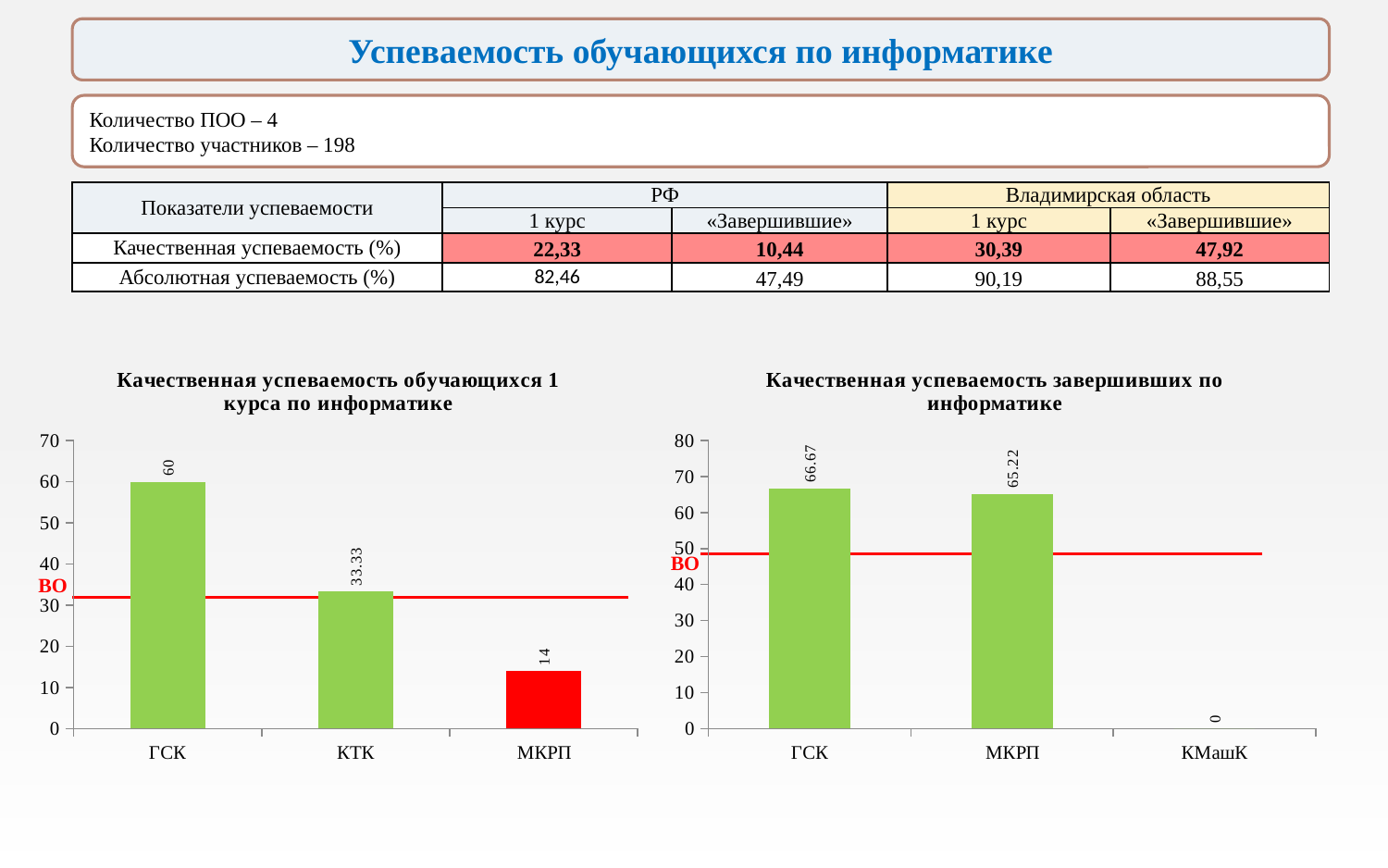
In the chart 'Качественная успеваемость обучающихся 1 курса по информатике', what is the value for ГСК? 60 In the chart 'Качественная успеваемость завершивших по информатике', is the value for МКРП greater or less than 60? greater In the chart 'Качественная успеваемость обучающихся 1 курса по информатике', which category has the lowest value? МКРП In the chart 'Качественная успеваемость завершивших по информатике', what is the value for ГСК? 66.67 What kind of chart is 'Качественная успеваемость завершивших по информатике'? bar chart In the chart 'Качественная успеваемость обучающихся 1 курса по информатике', what is the value for МКРП? 14 In the chart 'Качественная успеваемость обучающихся 1 курса по информатике', how many categories are shown on the x axis? 3 In the chart 'Качественная успеваемость завершивших по информатике', what is the value for МКРП? 65.22 In the chart 'Качественная успеваемость обучающихся 1 курса по информатике', what is the value for КТК? 33.33 In the chart 'Качественная успеваемость обучающихся 1 курса по информатике', what is the difference between the values for ГСК and МКРП? 46 In the chart 'Качественная успеваемость завершивших по информатике', what is the value for КМашК? 0 In the chart 'Качественная успеваемость завершивших по информатике', which category has the highest value? ГСК